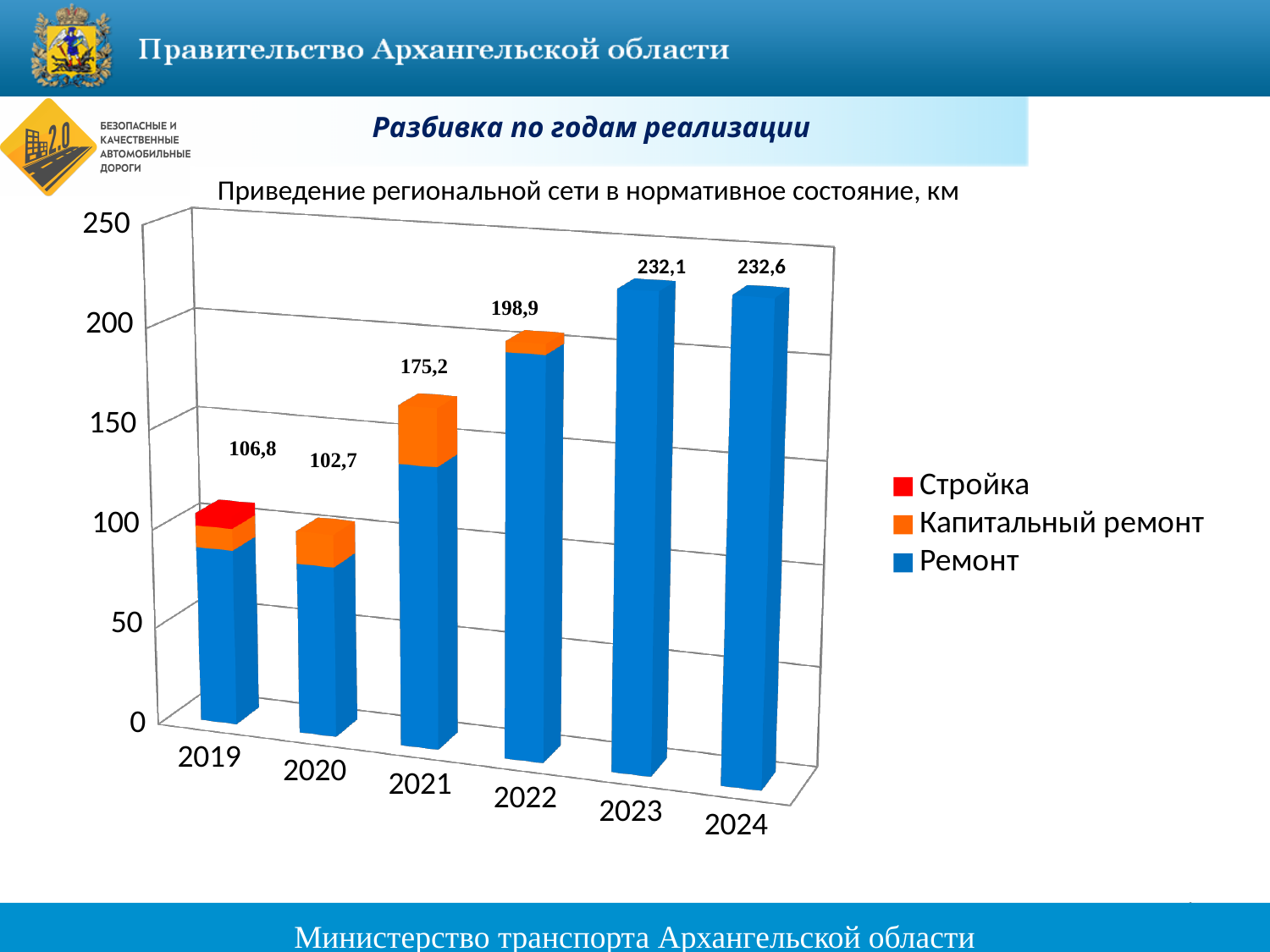
What is the total value labelled for 2023? 232,1 What is the difference between the labelled totals for 2021 and 2020? 72,5 Which is larger, the labelled total for 2022 or for 2021? 2022 How many series does the legend list? 3 What kind of chart is shown on the slide? Stacked bar chart What is the total value labelled for 2019? 106,8 What is the difference between the labelled totals for 2023 and 2019? 125,3 Which year has the lowest labelled total? 2020 Do the labelled totals rise or fall from 2020 to 2024? Rise How many years are shown on the x axis? 6 What is the total value labelled for 2021? 175,2 Which year has the highest labelled total? 2024